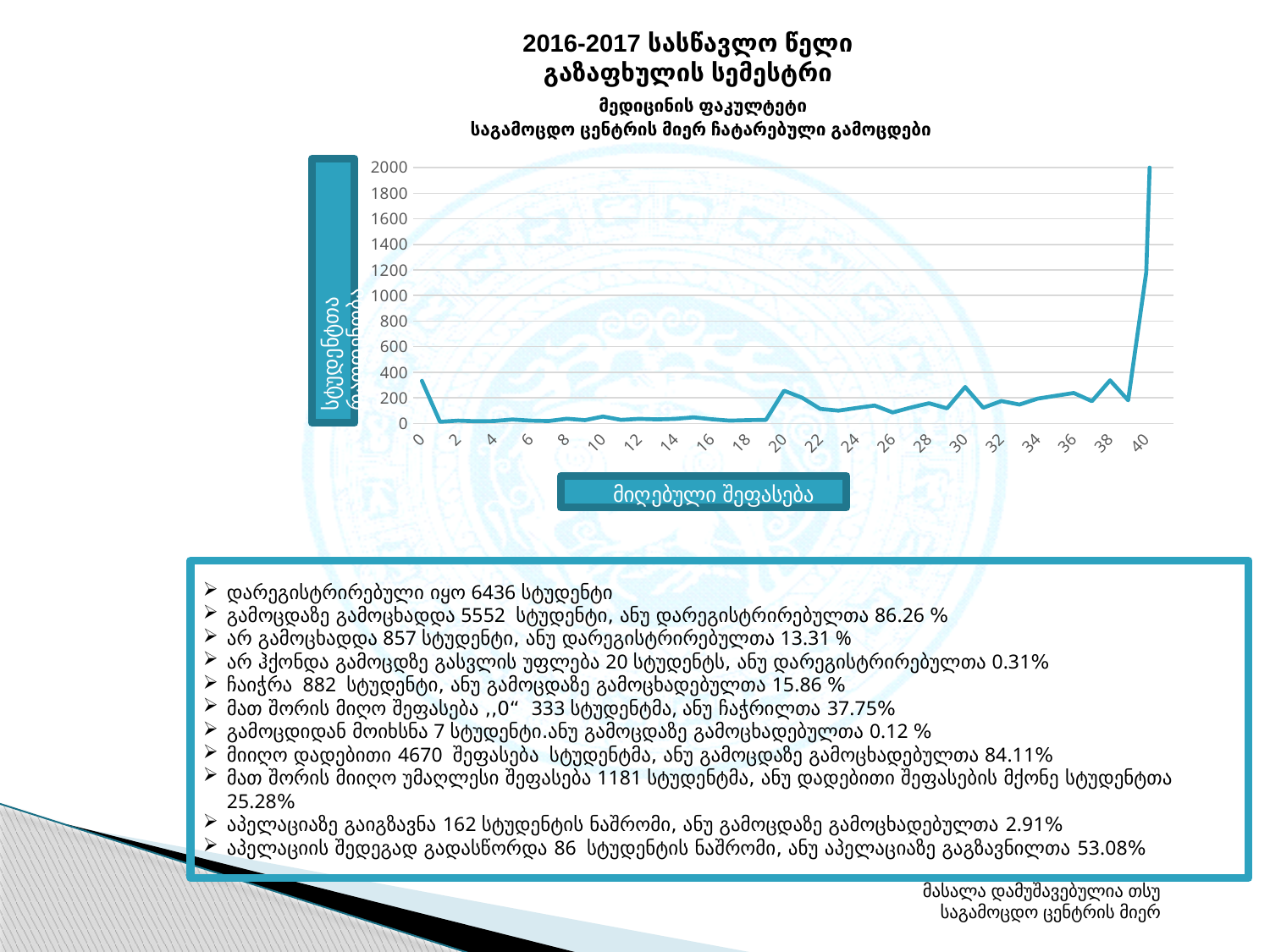
How many labelled tick marks are on the x axis (from 0 to 40 in steps of 2)? 21 Is the value at score 0 greater or less than 400? less What is the title of the x axis? მიღებული შეფასება What is the highest value labelled on the y axis? 2000 Which is larger, the value at score 40 or the value at score 0? score 40 Is the value at score 30 greater or less than 200? greater Is the value at score 10 greater or less than 200? less What kind of chart is shown on the slide? line chart Which is larger, the value at score 0 or the value at score 10? score 0